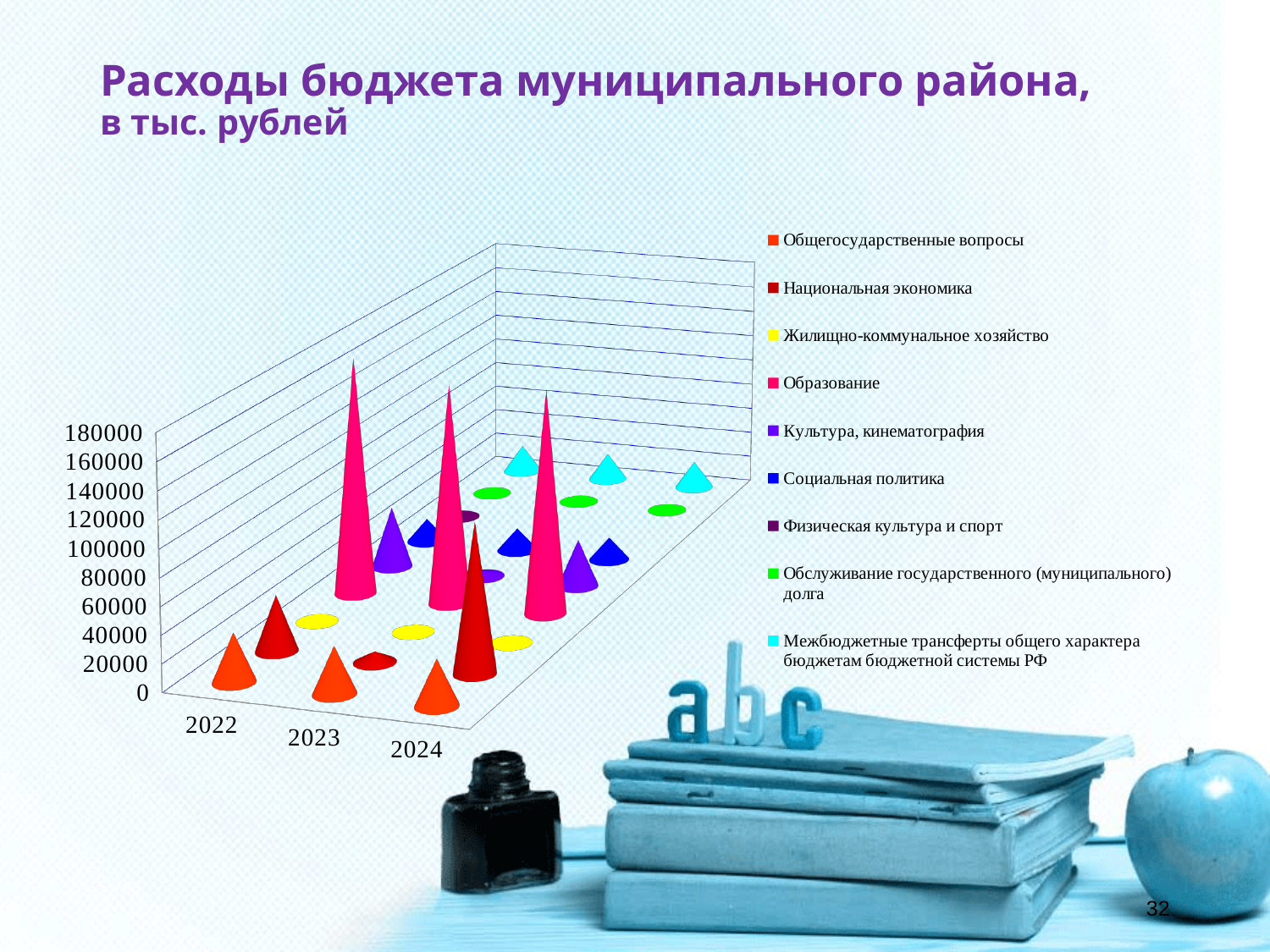
What is the first series listed in the chart legend? Общегосударственные вопросы What kind of chart is shown on the slide? bar chart Is the value for Жилищно-коммунальное хозяйство in 2023 greater or less than 40000? less Is the value for Образование in 2022 greater or less than 100000? greater Which years are shown as categories on the chart's x axis? 2022, 2023, 2024 Is the value for Общегосударственные вопросы in 2022 greater or less than 80000? less How many years are shown on the x axis of the chart? 3 Which series has the highest values in the chart? Образование What is the title of the chart on the slide? Расходы бюджета муниципального района, в тыс. рублей How many series does the chart legend list? 9 What is the highest value shown on the vertical axis of the chart? 180000 In 2022, which is larger: Образование or Общегосударственные вопросы? Образование